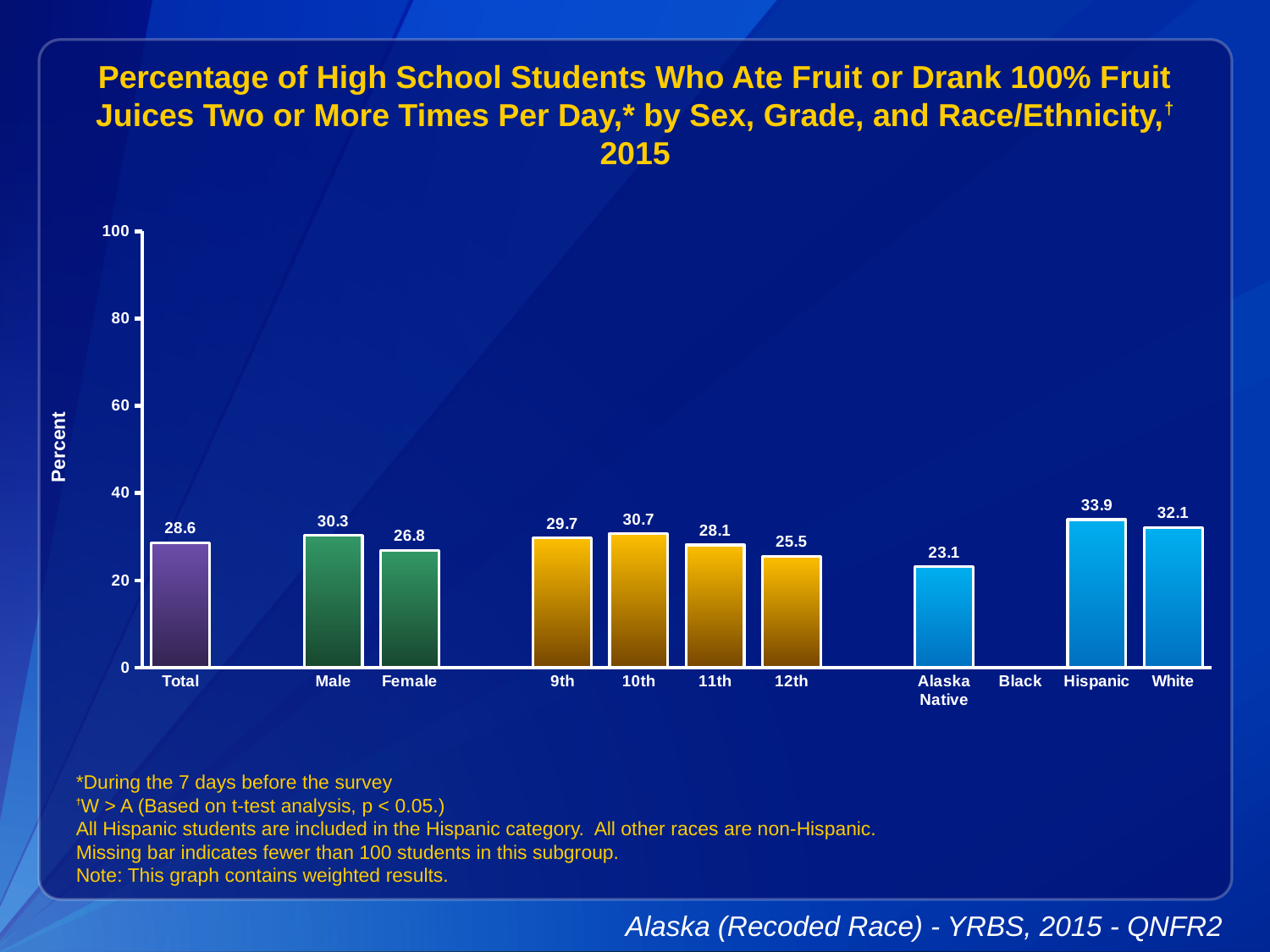
How many bars are plotted on the chart? 10 What is the value for Total? 28.6 Which category label has no bar plotted? Black What kind of chart is shown? bar chart Is the value for White greater or less than 40? less What is the value for Alaska Native? 23.1 What is the value for Female? 26.8 What is the difference between the Male and Female values? 3.5 Which category has the highest value? Hispanic Do the values fall from 10th grade to 12th grade? yes Which is larger, the value for 9th grade or 12th grade? 9th Which category has the lowest value among the bars shown? Alaska Native